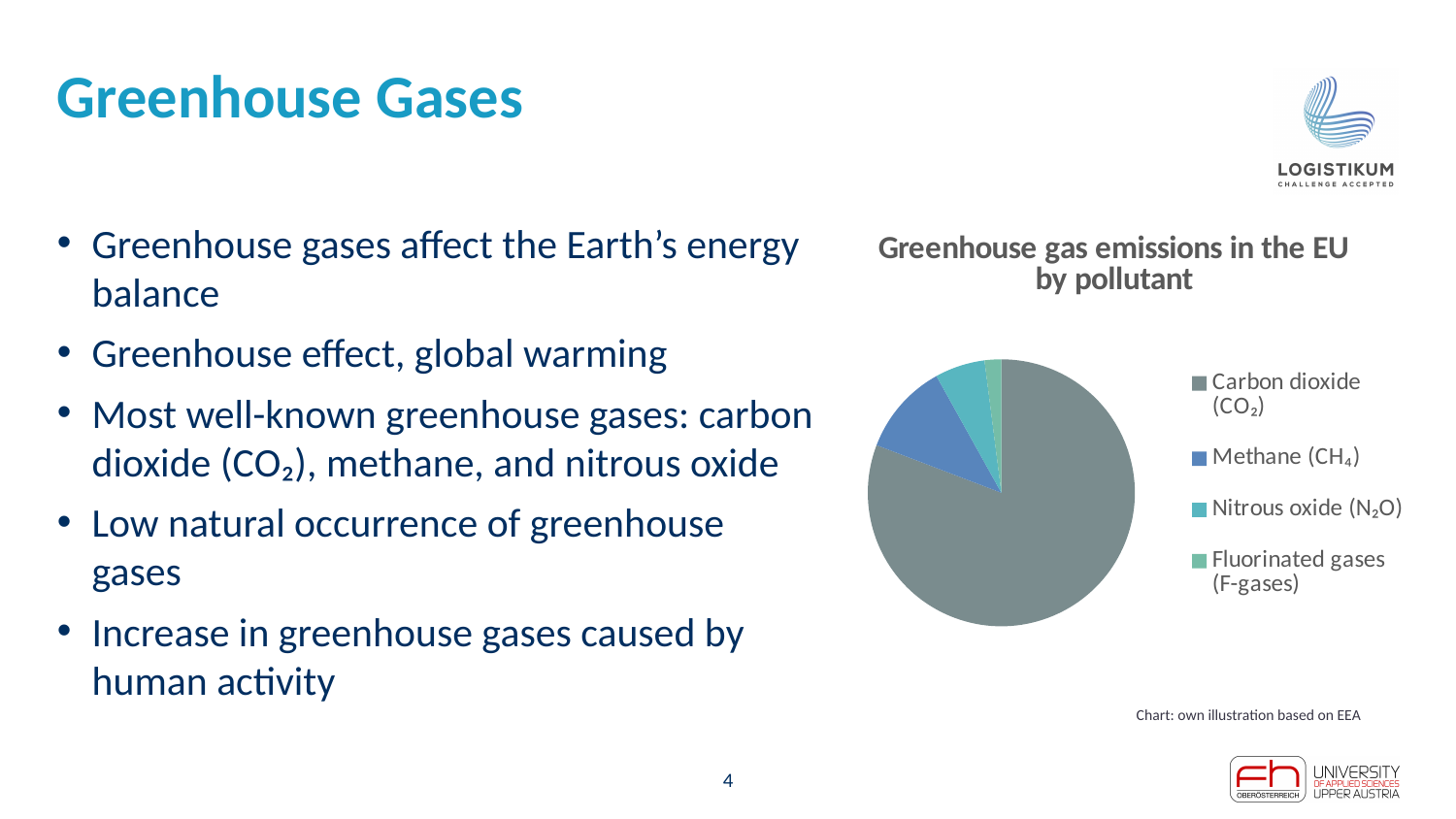
Which pollutant is listed second in the chart legend? Methane (CH₄) How many entries does the chart legend list? 4 Which pollutant has the smallest slice of the pie chart? Fluorinated gases (F-gases) Which has the larger slice in the pie chart, Carbon dioxide (CO₂) or Methane (CH₄)? Carbon dioxide (CO₂) What is the title of the chart? Greenhouse gas emissions in the EU by pollutant Which has the larger slice in the pie chart, Methane (CH₄) or Nitrous oxide (N₂O)? Methane (CH₄) What kind of chart is shown on the slide? Pie chart Which has the larger slice in the pie chart, Nitrous oxide (N₂O) or Fluorinated gases (F-gases)? Nitrous oxide (N₂O) Which pollutant has the largest slice of the pie chart? Carbon dioxide (CO₂) How many pollutant categories does the pie chart show? 4